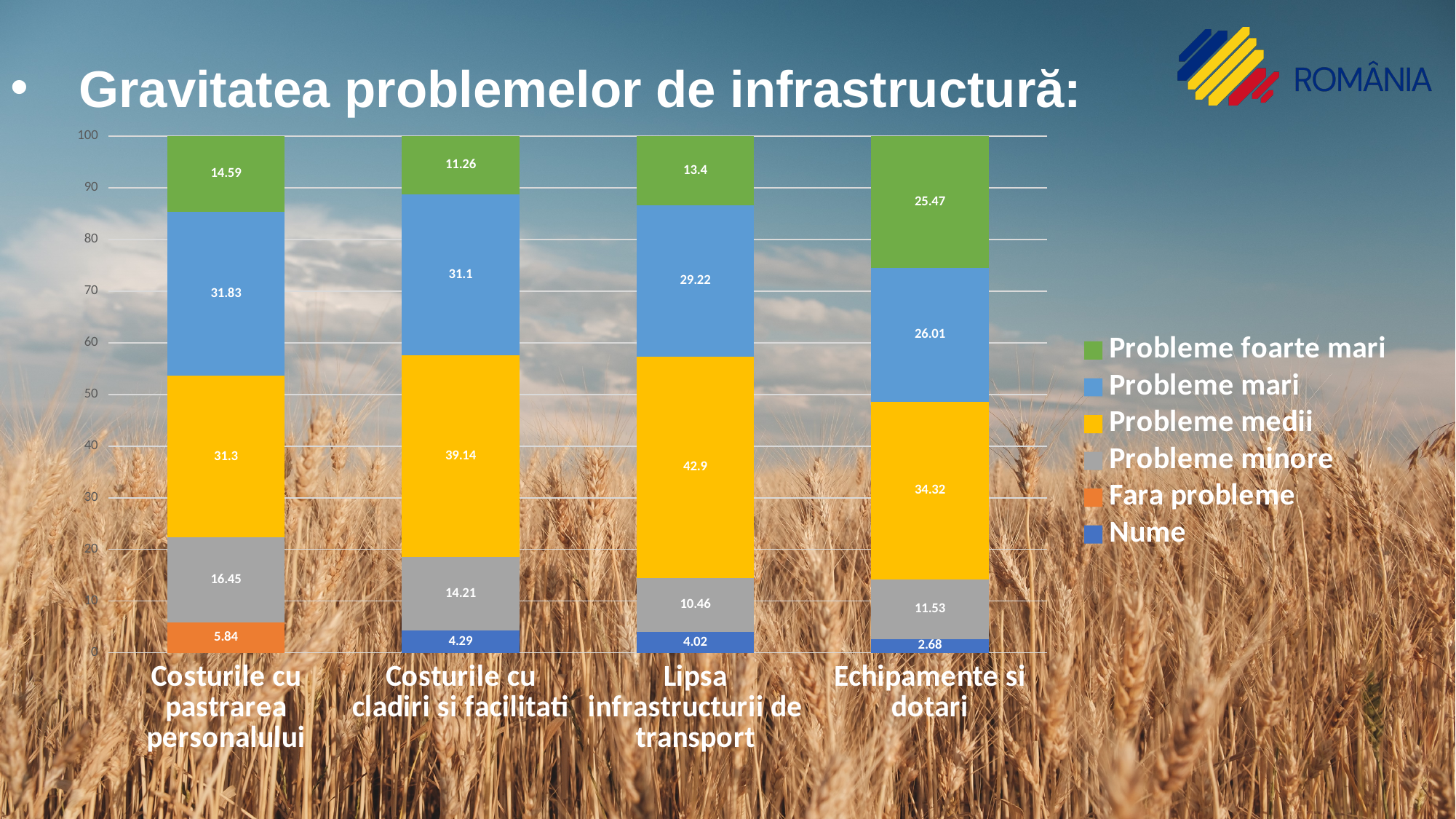
How many series does the chart legend list? 6 What type of chart is shown on the slide? Stacked bar chart Which category has the highest value for Probleme foarte mari? Echipamente si dotari What is the value of Probleme minore for Costurile cu pastrarea personalului? 16.45 Which is larger: the Probleme medii value for Costurile cu cladiri si facilitati or for Echipamente si dotari? Costurile cu cladiri si facilitati What is the value of Probleme medii for Lipsa infrastructurii de transport? 42.9 What is the value of Probleme foarte mari for Echipamente si dotari? 25.47 Which category has the lowest value for Probleme minore? Lipsa infrastructurii de transport How many categories are shown on the x axis of the chart? 4 What is the value of Probleme mari for Costurile cu cladiri si facilitati? 31.1 What is the title of the chart on the slide? Gravitatea problemelor de infrastructură: What is the difference between the Probleme medii values for Lipsa infrastructurii de transport and Costurile cu pastrarea personalului? 11.6